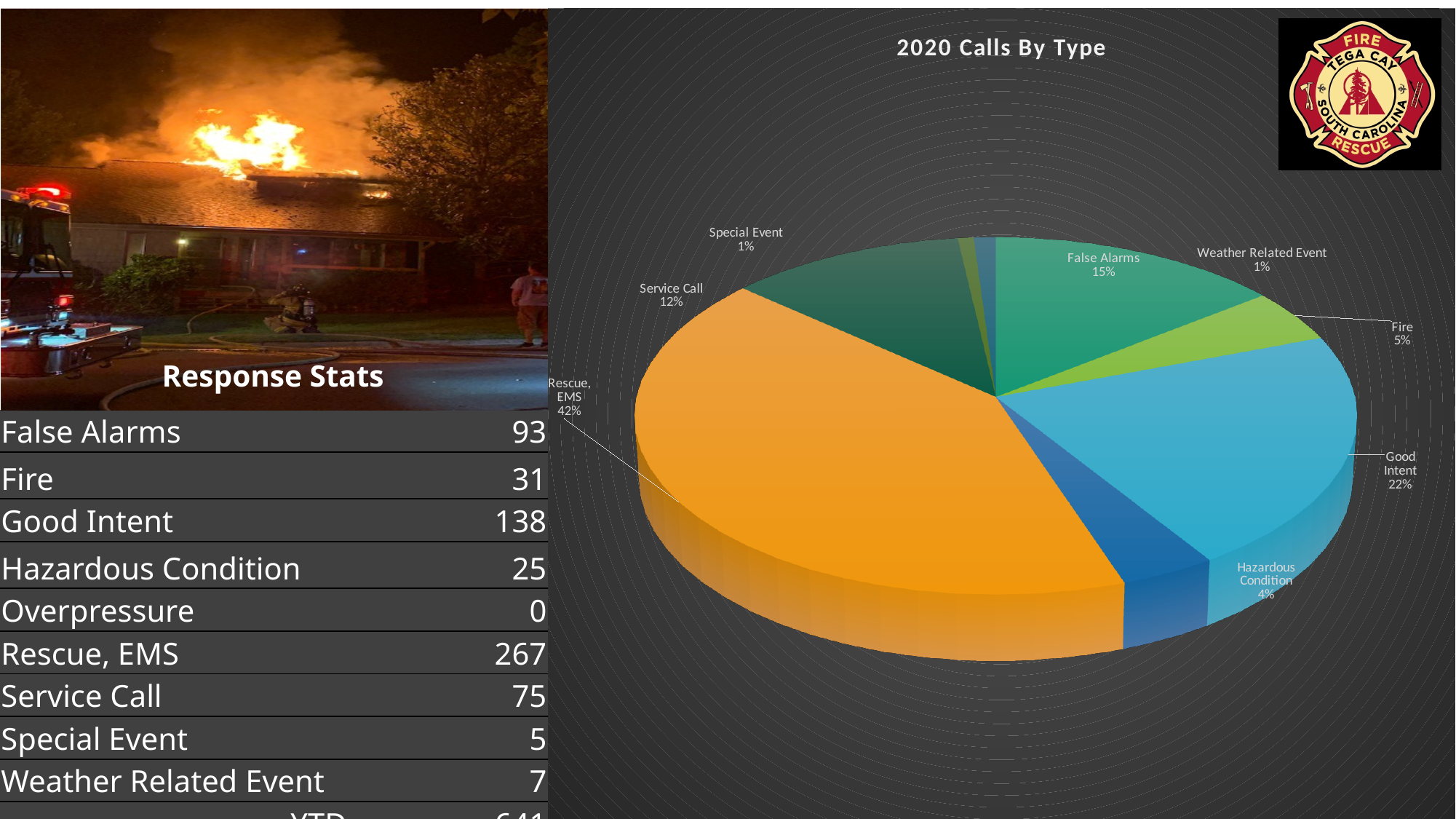
What percentage is shown for Fire in the pie chart? 5% What percentage is shown for Good Intent in the pie chart? 22% What percentage is shown for False Alarms in the pie chart? 15% What percentage is shown for Hazardous Condition in the pie chart? 4% What is the title of the pie chart? 2020 Calls By Type What is the difference in percentage points between the Good Intent and False Alarms slices? 7% Which slice is larger in the pie chart, Good Intent or False Alarms? Good Intent How many labeled slices does the pie chart have? 8 What percentage is shown for Service Call in the pie chart? 12% What share of the pie does Rescue, EMS represent? 42% What kind of chart is shown on the slide? pie chart Which call type has the largest slice of the pie chart? Rescue, EMS